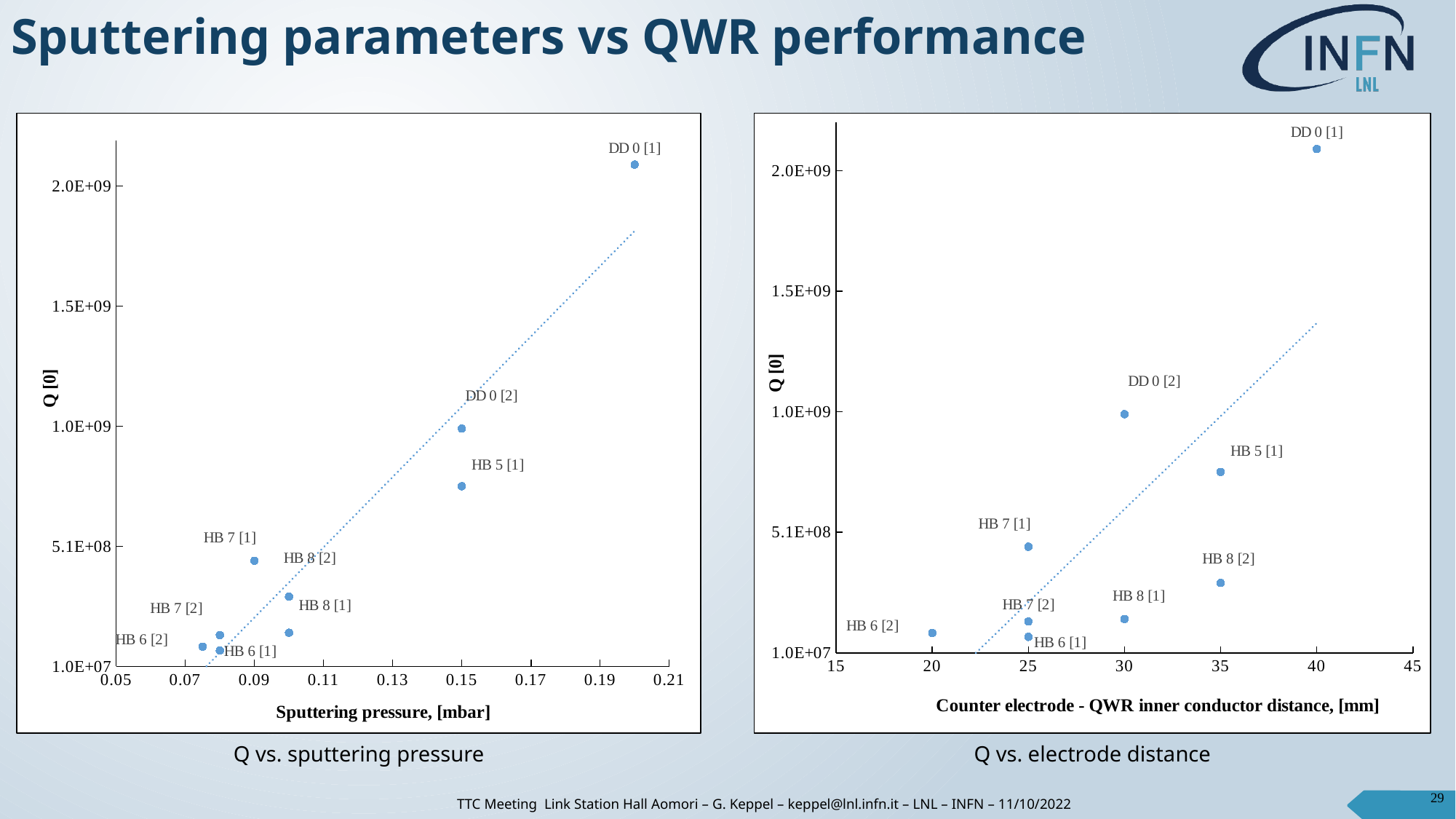
In the 'Q vs. electrode distance' chart, is the Q value for HB 5 [1] greater or less than 5.1E+08? greater In the 'Q vs. sputtering pressure' chart, is the Q value for HB 5 [1] greater or less than 1.0E+09? less In the 'Q vs. electrode distance' chart, is the Q value for DD 0 [2] greater or less than 1.5E+09? less In the 'Q vs. electrode distance' chart, which labelled point has the highest Q value? DD 0 [1] In the 'Q vs. sputtering pressure' chart, which labelled point has the highest Q value? DD 0 [1] In the 'Q vs. electrode distance' chart, which has the higher Q value, HB 7 [1] or HB 8 [2]? HB 7 [1] How many labelled data points are plotted in the 'Q vs. sputtering pressure' chart? 9 In the 'Q vs. electrode distance' chart, does the dotted trend line rise or fall as the electrode distance increases? Rises In the 'Q vs. sputtering pressure' chart, which has the higher Q value, DD 0 [2] or HB 5 [1]? DD 0 [2] In the 'Q vs. electrode distance' chart, at what counter electrode distance is the DD 0 [1] point plotted? 40 What kind of chart is the 'Q vs. electrode distance' chart? Scatter chart